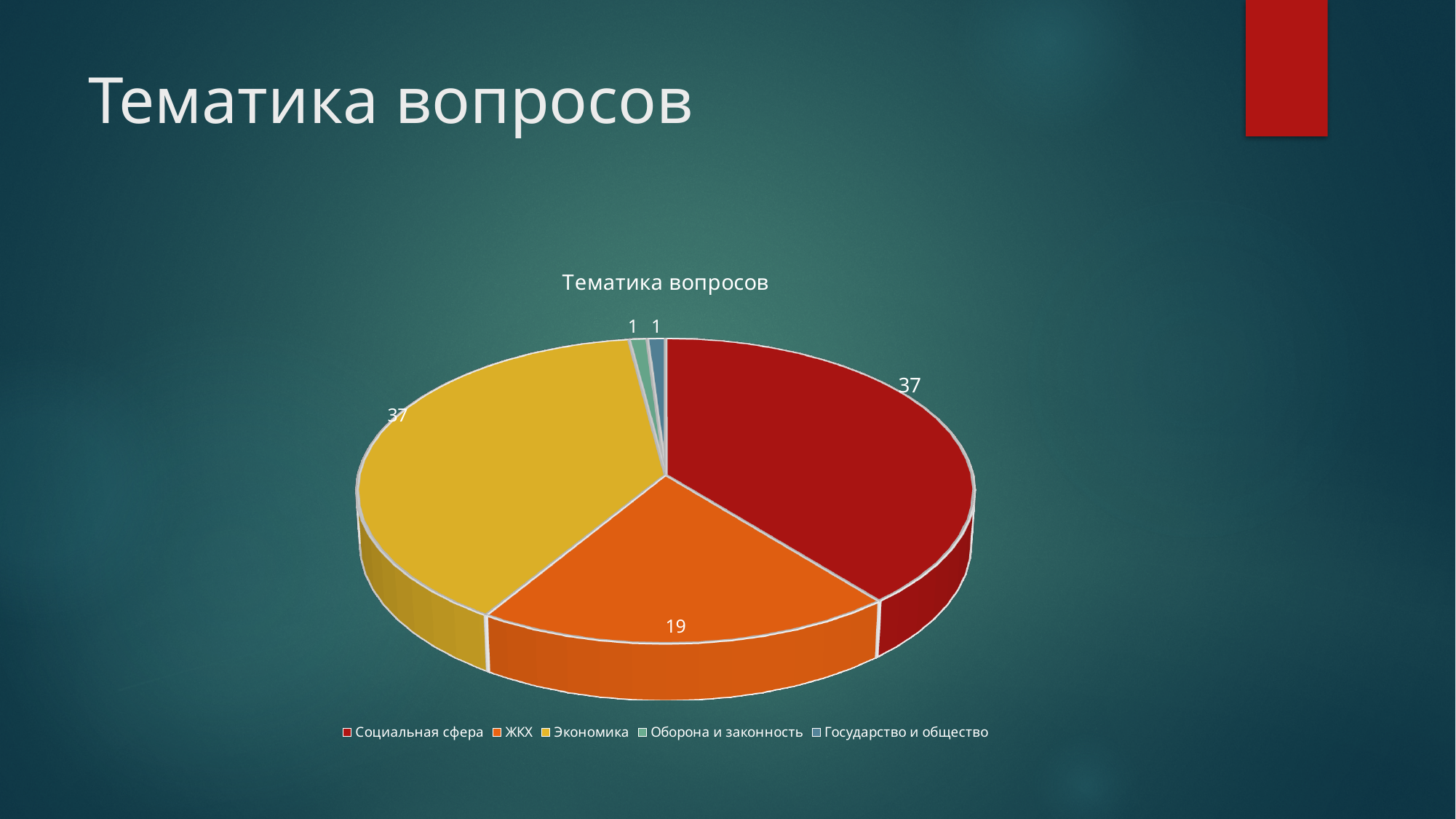
What is the value for Экономика? 37 What is the value for ЖКХ? 19 What is the title of the chart? Тематика вопросов What is the difference between the value for Экономика and the value for ЖКХ? 18 What is the value for Социальная сфера? 37 Which is larger, the value for Социальная сфера or the value for ЖКХ? Социальная сфера How many categories does the pie chart have? 5 What is the value for Оборона и законность? 1 What is the value for Государство и общество? 1 What share of the pie does ЖКХ represent? 20% What colour is the slice for ЖКХ? orange What type of chart is shown on the slide? pie chart